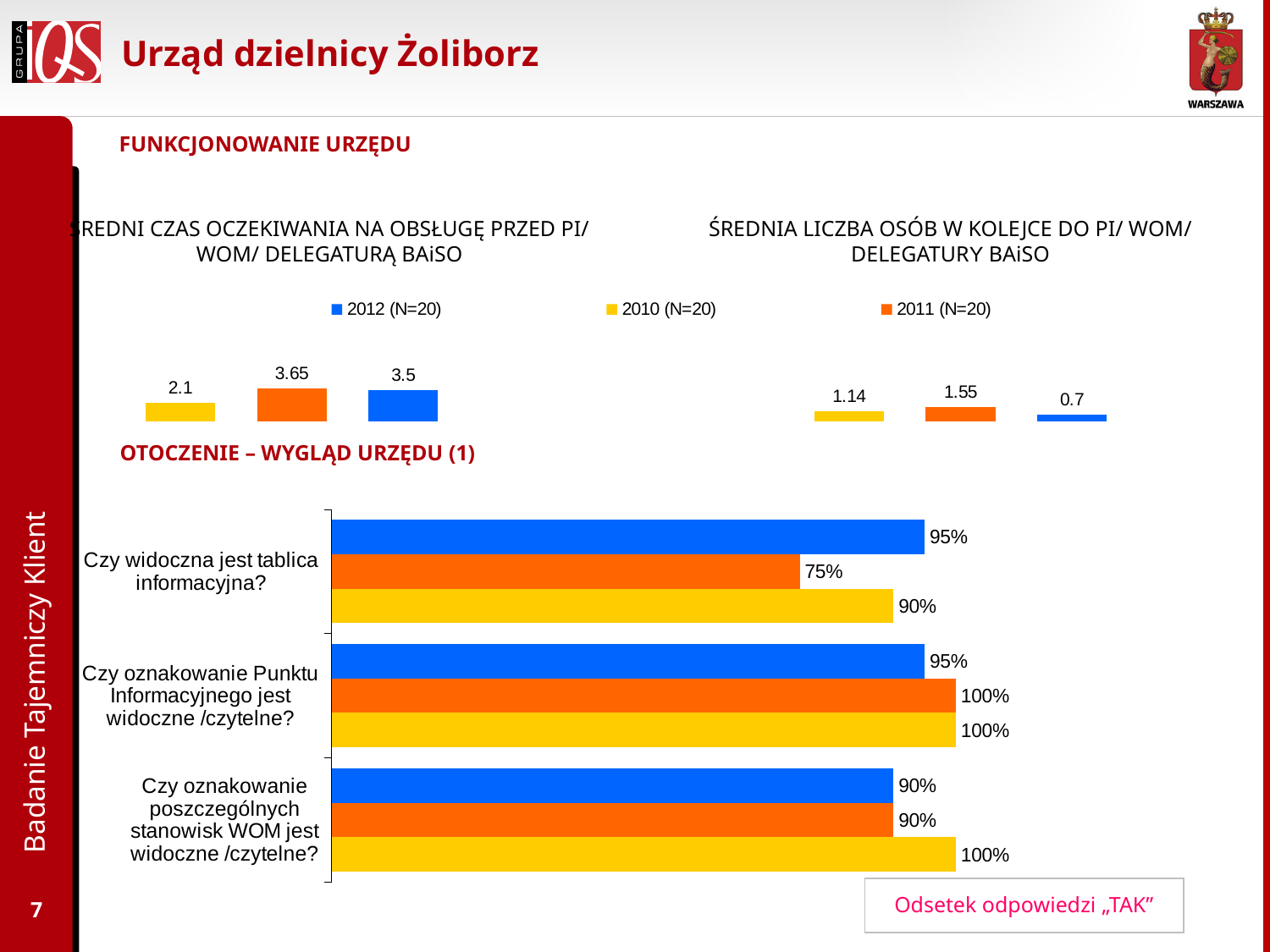
In the bottom chart under 'OTOCZENIE – WYGLĄD URZĘDU (1)', what is the difference between the 2012 and 2011 values for 'Czy widoczna jest tablica informacyjna?'? 20% In the chart 'ŚREDNIA LICZBA OSÓB W KOLEJCE DO PI/ WOM/ DELEGATURY BAiSO', what is the value for 2011 (N=20)? 1.55 In the bottom chart under 'OTOCZENIE – WYGLĄD URZĘDU (1)', how many question categories are shown? 3 In the chart 'ŚREDNI CZAS OCZEKIWANIA NA OBSŁUGĘ PRZED PI/ WOM/ DELEGATURĄ BAiSO', which year has the highest value? 2011 (N=20) In the chart 'ŚREDNI CZAS OCZEKIWANIA NA OBSŁUGĘ PRZED PI/ WOM/ DELEGATURĄ BAiSO', what is the value for 2012 (N=20)? 3.5 How many series does the legend on the slide list? 3 What kind of chart is the bottom chart under 'OTOCZENIE – WYGLĄD URZĘDU (1)'? Bar chart In the chart 'ŚREDNIA LICZBA OSÓB W KOLEJCE DO PI/ WOM/ DELEGATURY BAiSO', which year has the lowest value? 2012 (N=20) In the chart 'ŚREDNIA LICZBA OSÓB W KOLEJCE DO PI/ WOM/ DELEGATURY BAiSO', which is larger: the value for 2010 or the value for 2012? 2010 In the bottom chart under 'OTOCZENIE – WYGLĄD URZĘDU (1)', what is the 2010 value for 'Czy oznakowanie poszczególnych stanowisk WOM jest widoczne /czytelne?'? 100% In the chart 'ŚREDNI CZAS OCZEKIWANIA NA OBSŁUGĘ PRZED PI/ WOM/ DELEGATURĄ BAiSO', what is the difference between the 2011 and 2010 values? 1.55 In the bottom chart under 'OTOCZENIE – WYGLĄD URZĘDU (1)', what is the 2011 value for 'Czy widoczna jest tablica informacyjna?'? 75%